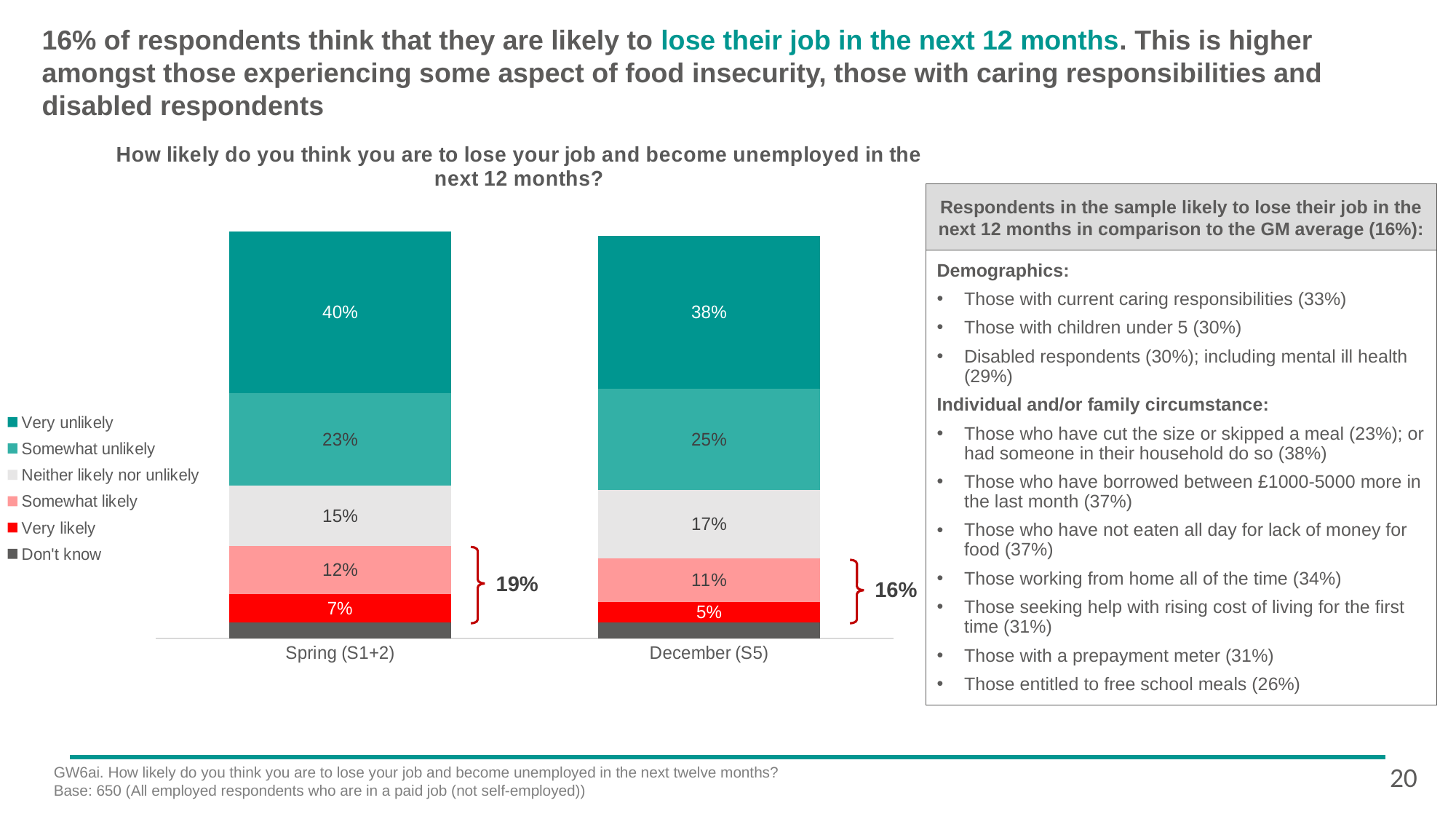
What is the 'Very likely' value for December (S5)? 5% Which period has the larger 'Somewhat likely' value, Spring (S1+2) or December (S5)? Spring (S1+2) Which period has the larger 'Neither likely nor unlikely' value? December (S5) How many periods (bars) are shown on the chart? 2 What percentage of respondents said 'Somewhat unlikely' in December (S5)? 25% What type of chart is shown? Stacked bar chart What combined percentage is shown by the bracket for 'Somewhat likely' and 'Very likely' in Spring (S1+2)? 19% How many series does the legend list? 6 What percentage of respondents said 'Very unlikely' in Spring (S1+2)? 40% What is the 'Neither likely nor unlikely' value for Spring (S1+2)? 15% What is the difference between the 'Very unlikely' values for Spring (S1+2) and December (S5)? 2% Which legend entry is shown in bright red? Very likely